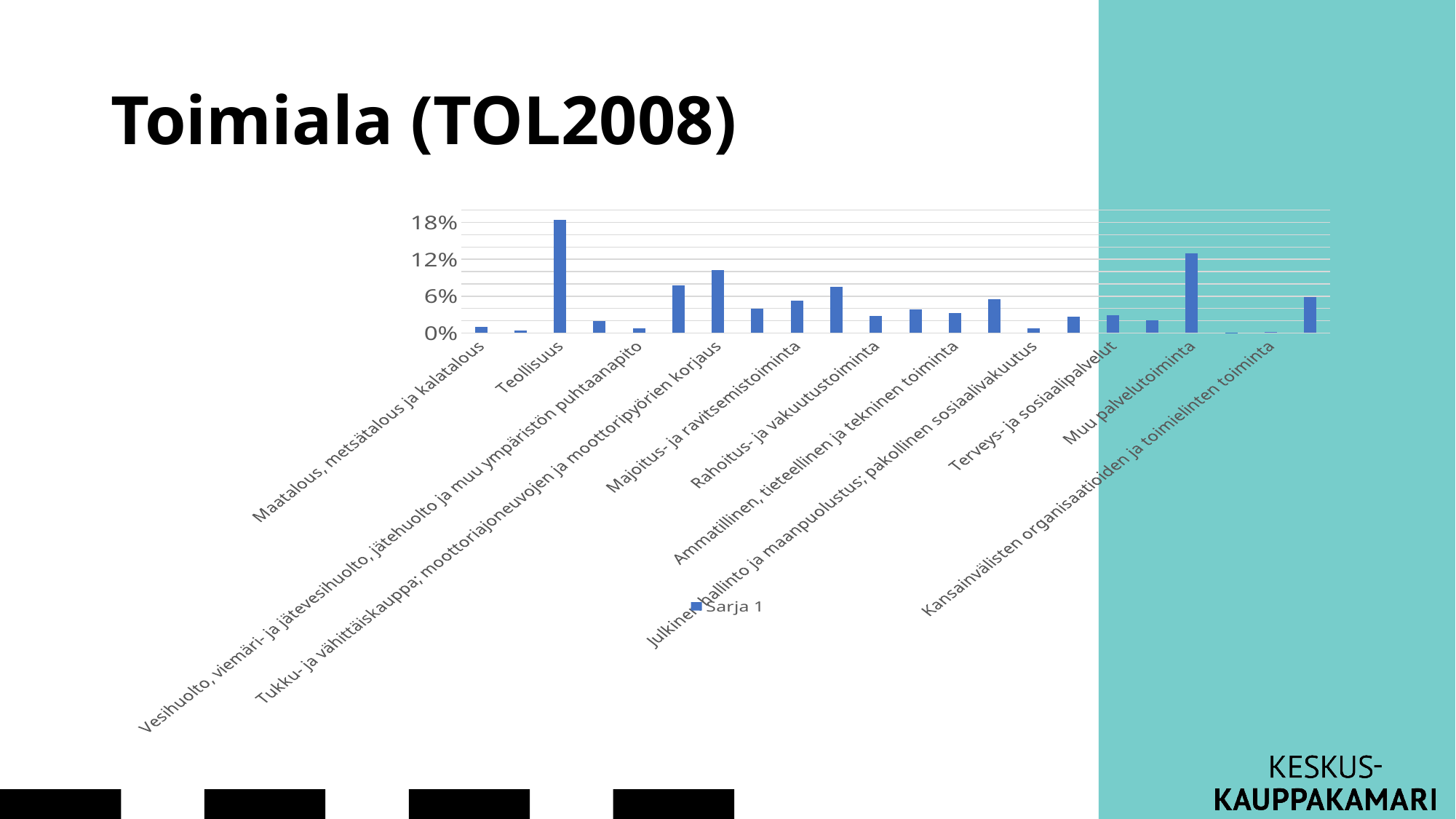
Which has the larger value, Tukku- ja vähittäiskauppa; moottoriajoneuvojen ja moottoripyörien korjaus or Majoitus- ja ravitsemistoiminta? Tukku- ja vähittäiskauppa; moottoriajoneuvojen ja moottoripyörien korjaus Is the value for Maatalous, metsätalous ja kalatalous greater or less than 6%? less What is the name of the series shown in the legend? Sarja 1 Which has the larger value, Teollisuus or Muu palvelutoiminta? Teollisuus How many series does the legend list? 1 Is the value for Teollisuus greater or less than 12%? greater What is the highest tick value shown on the vertical axis? 18% Is the value for Muu palvelutoiminta greater or less than 12%? greater What kind of chart is shown on the slide? bar chart Which category has the highest value in the chart? Teollisuus